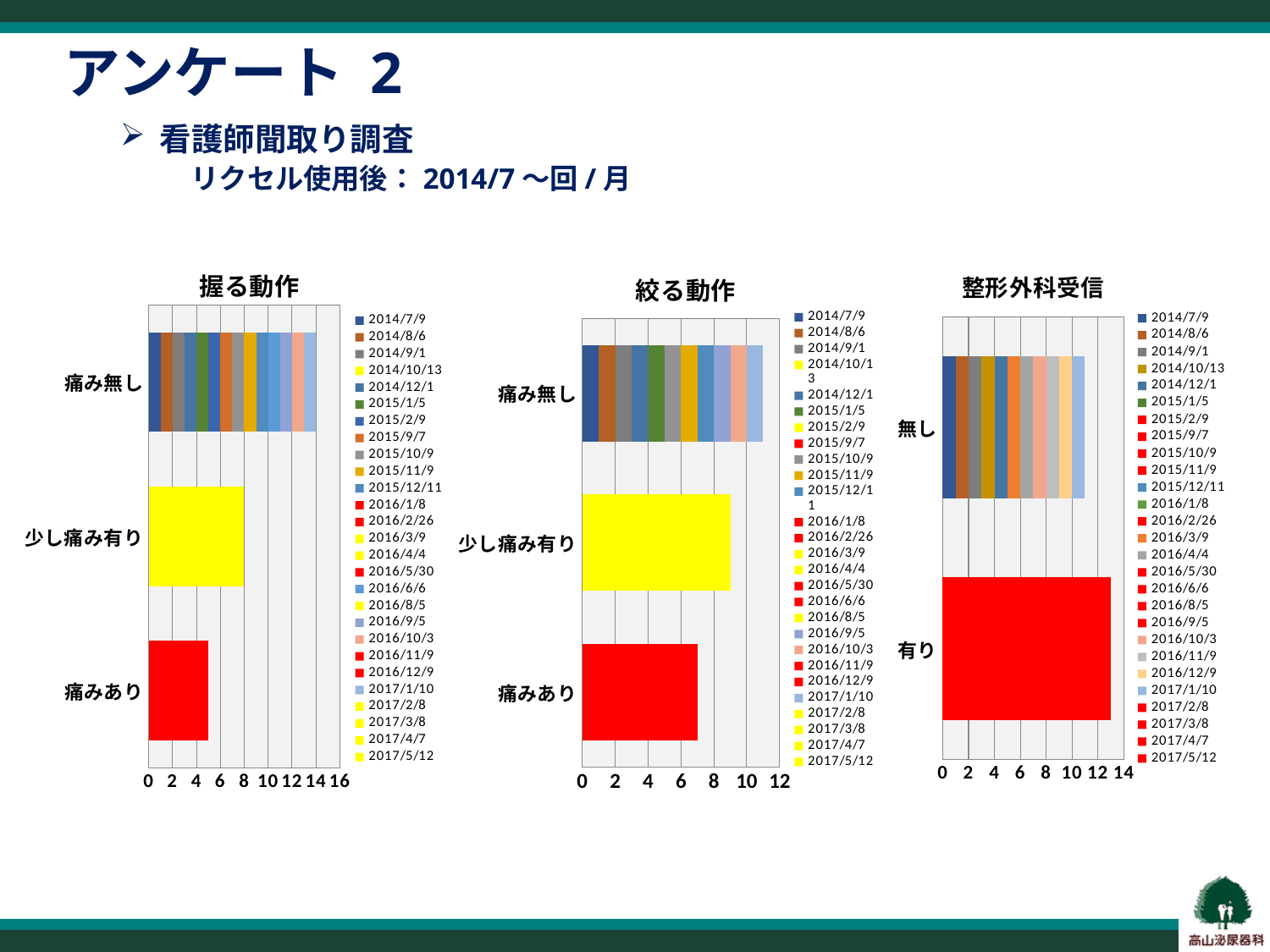
What kind of chart is the 握る動作 chart? bar chart In the 整形外科受信 chart, which bar is longer, 無し or 有り? 有り What is the title of the rightmost chart on the slide? 整形外科受信 How many series does the legend of the 絞る動作 chart list? 27 How many categories does the 握る動作 chart show on its vertical axis? 3 In the 握る動作 chart, is the total for 痛み無し greater or less than 12? greater In the 絞る動作 chart, is the total for 痛みあり greater or less than 8? less In the 絞る動作 chart, which category has the longest bar? 痛み無し In the 握る動作 chart, is the total for 痛みあり greater or less than 8? less In the 握る動作 chart, which category has the shortest bar? 痛みあり In the 握る動作 chart, which category has the longest bar? 痛み無し How many categories does the 整形外科受信 chart show on its vertical axis? 2